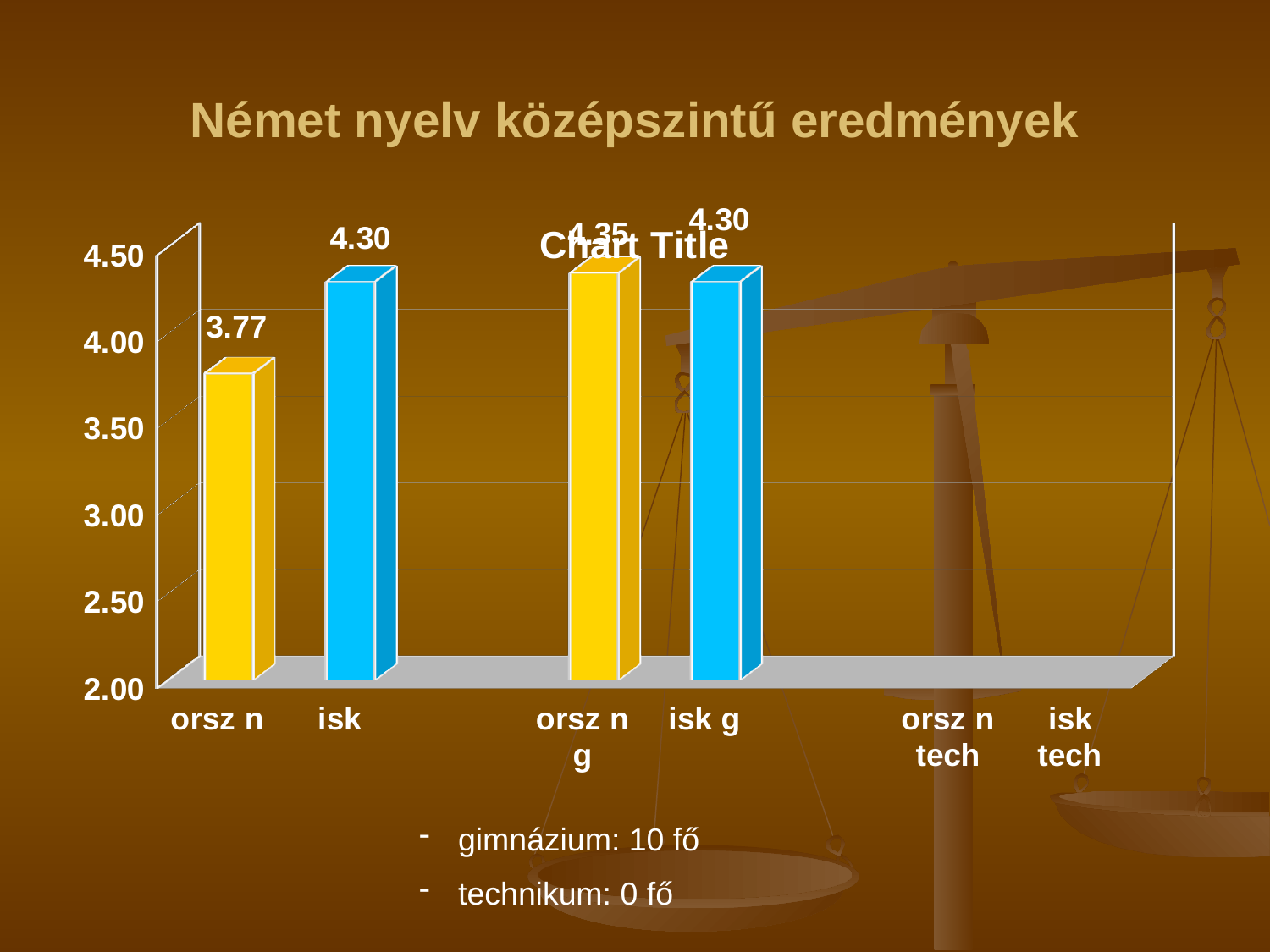
Which is larger, the value for orsz n or the value for isk? isk What is the title of the slide? Német nyelv középszintű eredmények How many category labels are shown on the x axis? 6 What is the difference between the values for isk and orsz n? 0.53 Is the value for orsz n g greater or less than 4.00? greater What is the value for orsz n? 3.77 How many bars are plotted in the chart? 4 Which category has the lowest value? orsz n What kind of chart is shown? bar chart What is the value for isk g? 4.30 What is the value for isk? 4.30 Is the value for orsz n greater or less than 4.00? less